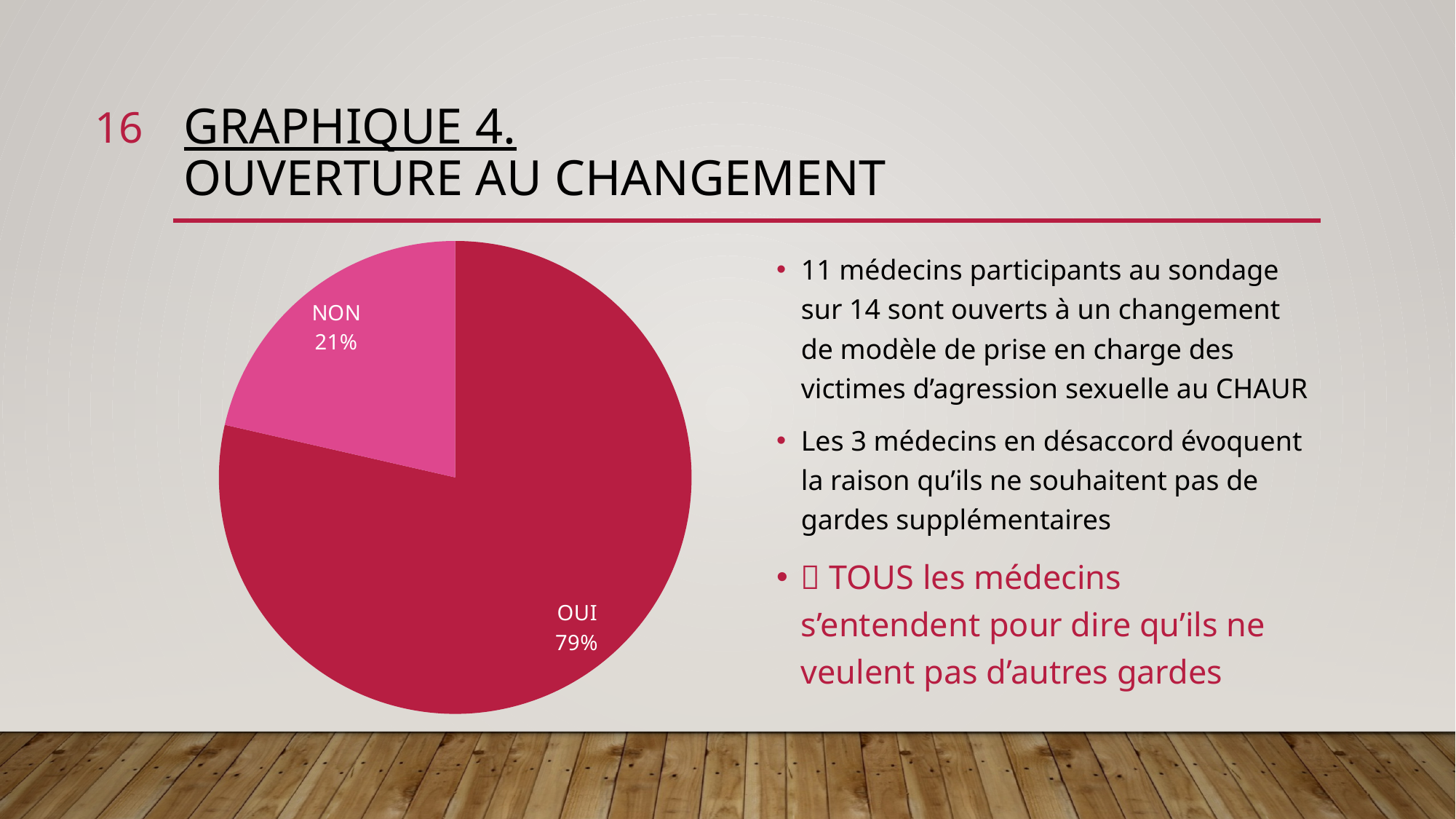
What is the title of the slide containing the chart? Graphique 4. Ouverture au changement Which slice of the pie is the largest? OUI What is the difference in percentage points between the OUI and NON slices? 58 What share of the pie does the NON slice represent? 21% Which slice is drawn in the lighter pink colour? NON Which slice of the pie is the smallest? NON What kind of chart is shown on the slide? Pie chart Is the value for NON greater or less than 25%? less Which slice is larger, OUI or NON? OUI What share of the pie does the OUI slice represent? 79% Is the value for OUI greater or less than 75%? greater How many slices does the pie chart have? 2